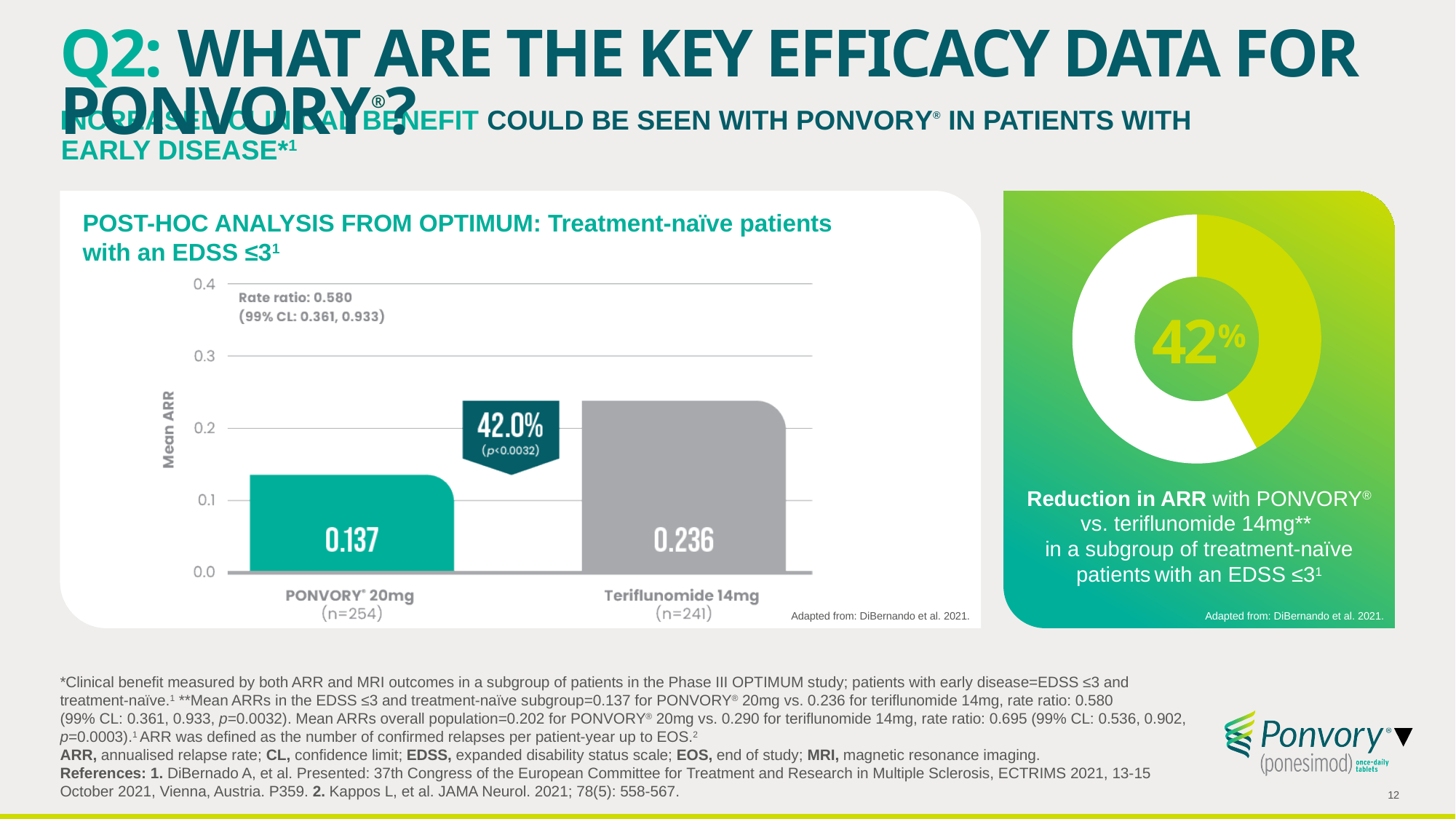
In the bar chart on the left, which treatment has the lower mean ARR? PONVORY 20mg In the bar chart on the left, what is the difference in mean ARR between Teriflunomide 14mg and PONVORY 20mg? 0.099 In the bar chart on the left, is the mean ARR for PONVORY 20mg greater or less than 0.2? less How many bars are shown in the bar chart on the left? 2 In the bar chart on the left, what is the label of the y axis? Mean ARR In the donut chart on the right, what percentage is shown in the centre? 42% In the bar chart on the left, what is the mean ARR for Teriflunomide 14mg? 0.236 In the bar chart on the left, is the mean ARR for Teriflunomide 14mg greater or less than 0.2? greater In the bar chart on the left, what rate ratio is printed above the bars? 0.580 What kind of chart is shown on the left side of the slide? Bar chart In the bar chart on the left, which treatment has the higher mean ARR? Teriflunomide 14mg In the bar chart on the left, what is the mean ARR for PONVORY 20mg? 0.137